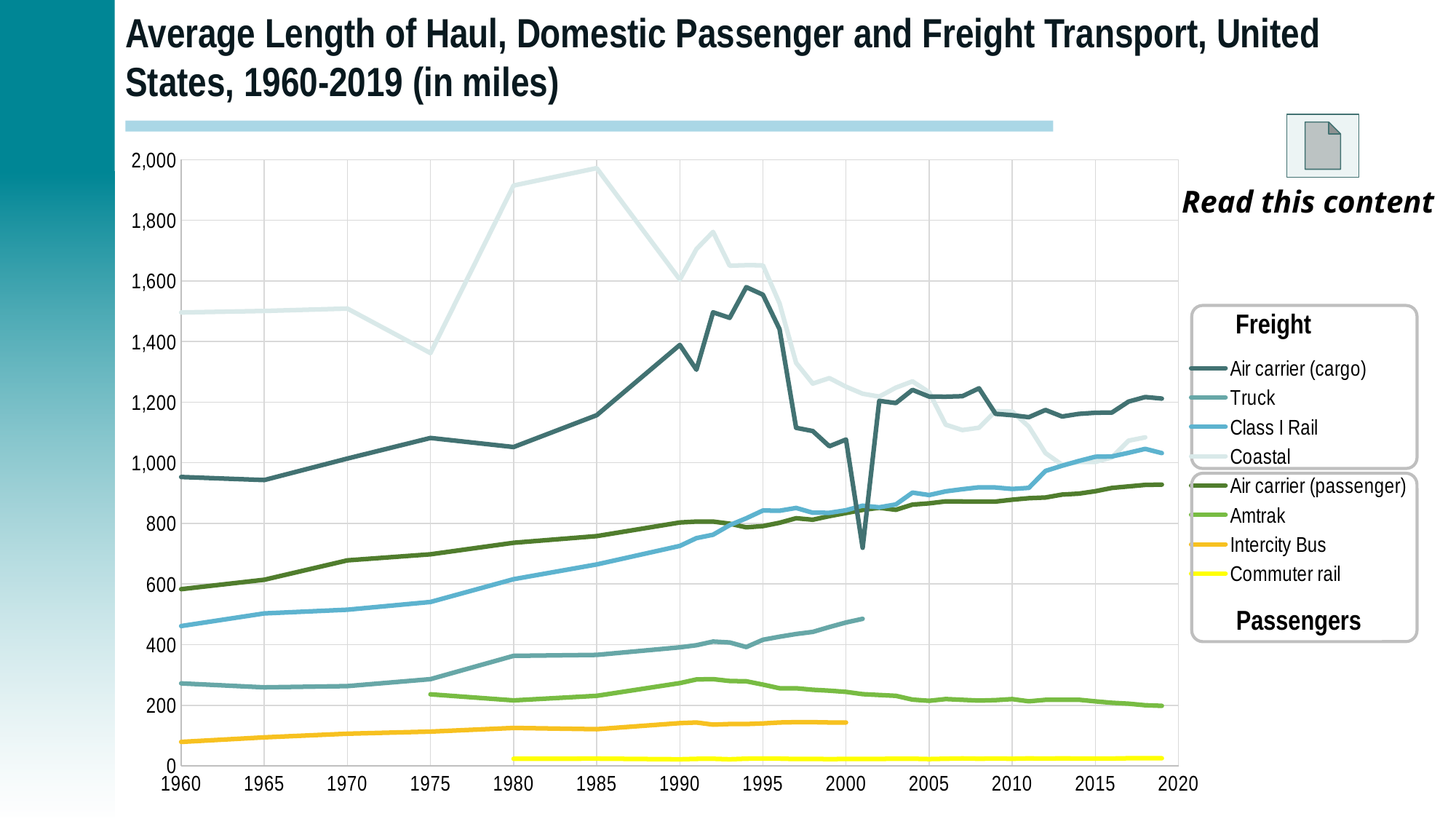
Is the value for Coastal in 1985 greater or less than 1,800? greater Does the Class I Rail series generally rise or fall from 1960 to 2019? rise In 1960, which is larger: Air carrier (cargo) or Class I Rail? Air carrier (cargo) Is the value for Truck in 2000 greater or less than 400? greater Which series has the lowest values across the chart? Commuter rail Which series has the highest value in 1985? Coastal Is the value for Air carrier (passenger) in 2019 greater or less than 1,000? less What kind of chart is shown on the slide? Line chart How many series does the legend list in total? 8 Which two groups does the legend divide the series into? Freight and Passengers